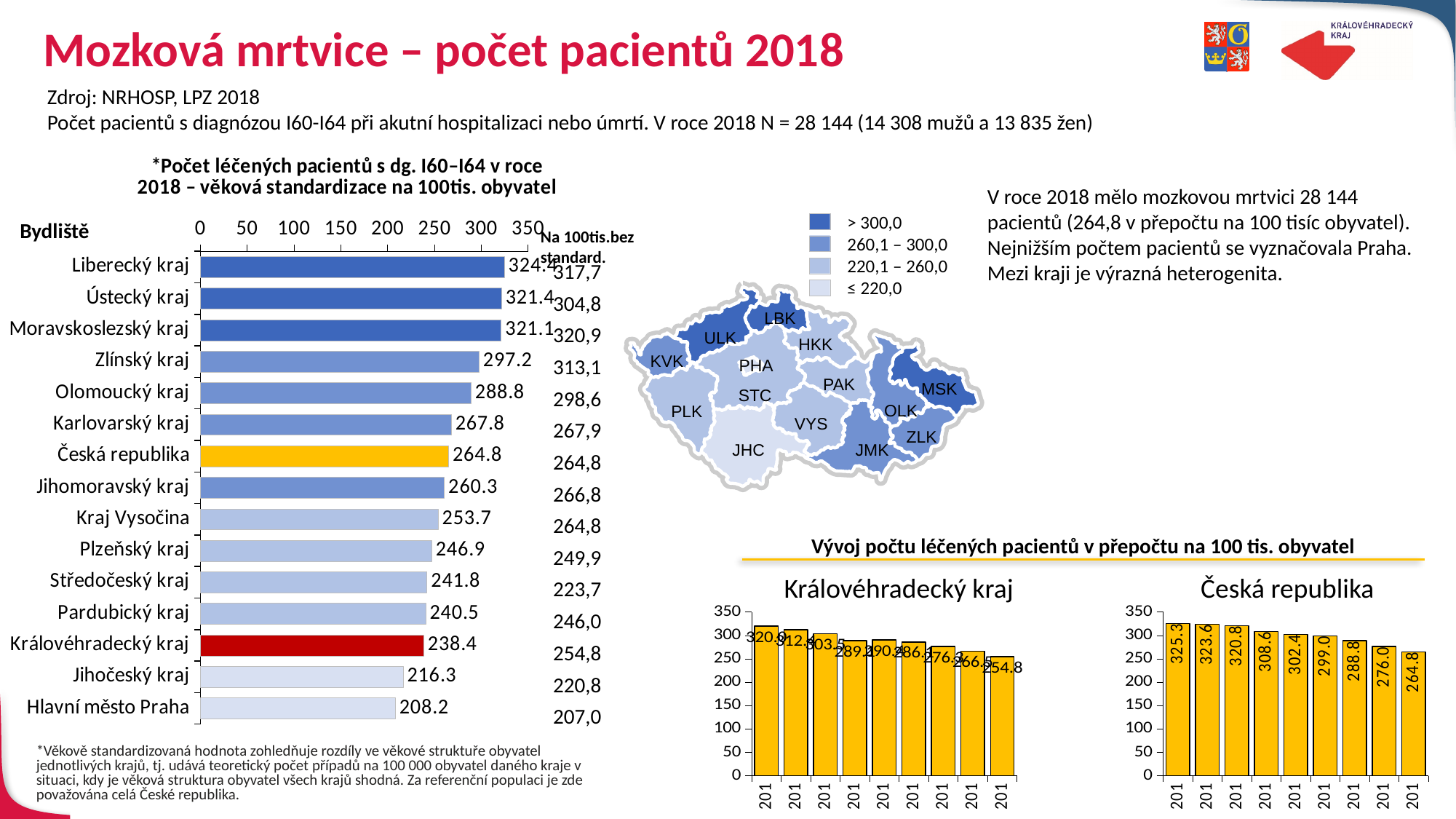
How many bars (regions including Česká republika) are shown in the left bar chart of age-standardized patients per 100 thousand inhabitants in 2018? 15 In the bottom-right chart titled Česká republika, what is the value of the last (rightmost) bar? 264.8 In the left bar chart of age-standardized patients per 100 thousand inhabitants in 2018, what is the value for Liberecký kraj? 324.4 In the left bar chart of age-standardized patients per 100 thousand inhabitants in 2018, which region has the highest value? Liberecký kraj In the left bar chart of age-standardized patients per 100 thousand inhabitants in 2018, what is the value for Královéhradecký kraj? 238.4 In the bottom-right chart titled Česká republika, do the values rise or fall over time from left to right? Fall In the left bar chart of age-standardized patients per 100 thousand inhabitants in 2018, which region has the lowest value? Hlavní město Praha How many bars are shown in the bottom chart titled Královéhradecký kraj? 9 In the left bar chart of age-standardized patients per 100 thousand inhabitants in 2018, what is the difference between Česká republika and Královéhradecký kraj? 26.4 What type of chart is the left chart of age-standardized patients per 100 thousand inhabitants in 2018? Bar chart In the left bar chart of age-standardized patients per 100 thousand inhabitants in 2018, which bar is coloured yellow? Česká republika In the left bar chart of age-standardized patients per 100 thousand inhabitants in 2018, which is larger: Zlínský kraj or Olomoucký kraj? Zlínský kraj